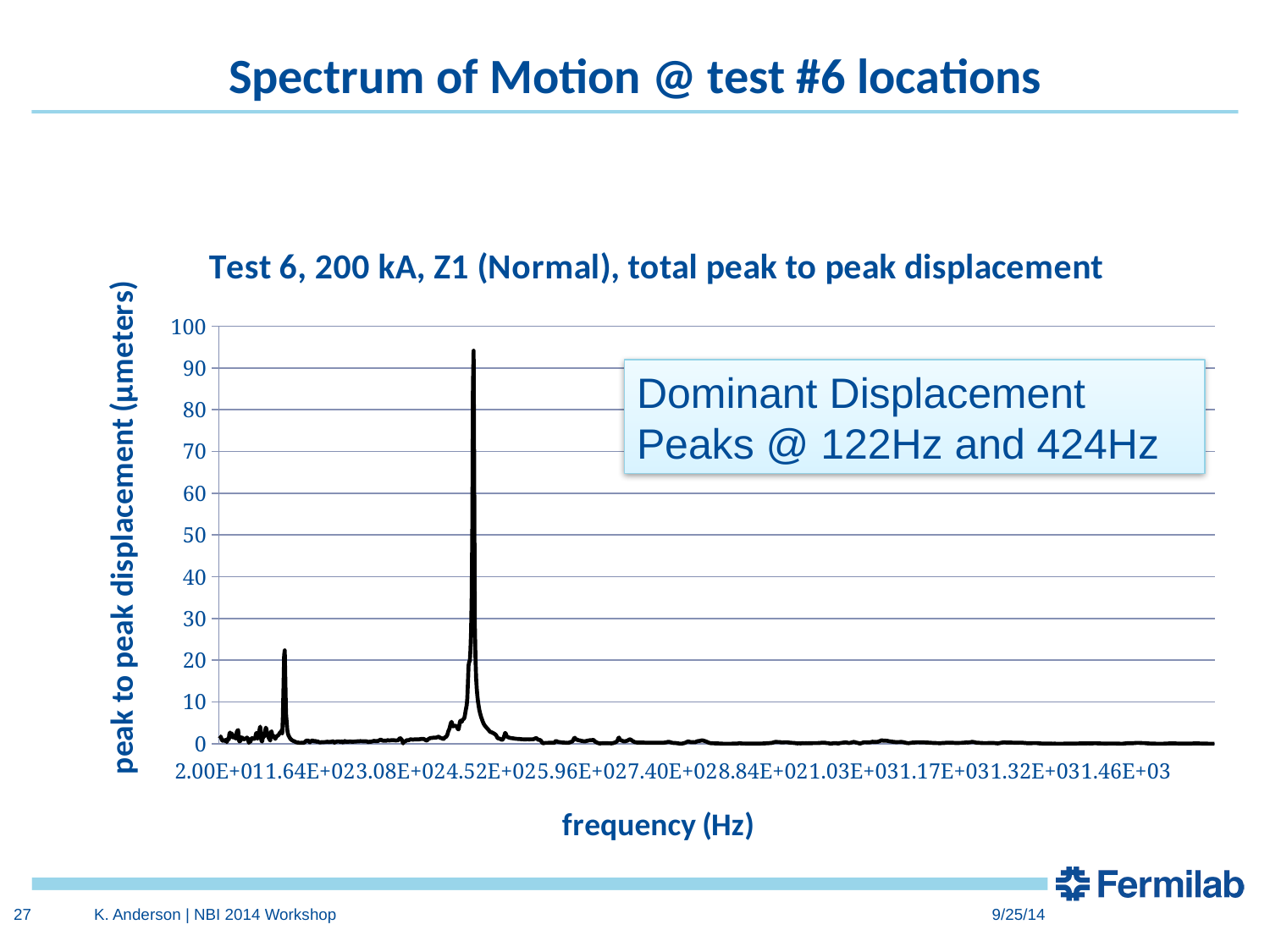
What is the title of the chart? Test 6, 200 kA, Z1 (Normal), total peak to peak displacement What is the label of the y axis? peak to peak displacement (µmeters) According to the annotation, at which two frequencies are the dominant displacement peaks? 122Hz and 424Hz What is the highest value shown on the y axis? 100 Which peak is larger, the one at 122Hz or the one at 424Hz? 424Hz At which frequency does the highest peak to peak displacement occur? 424Hz Is the peak displacement value at 122Hz greater or less than 10? greater Is the peak displacement value at 122Hz greater or less than 30? less Is the peak displacement value at 424Hz greater or less than 100? less What kind of chart is shown on the slide? line chart How many tick labels are shown along the x axis? 11